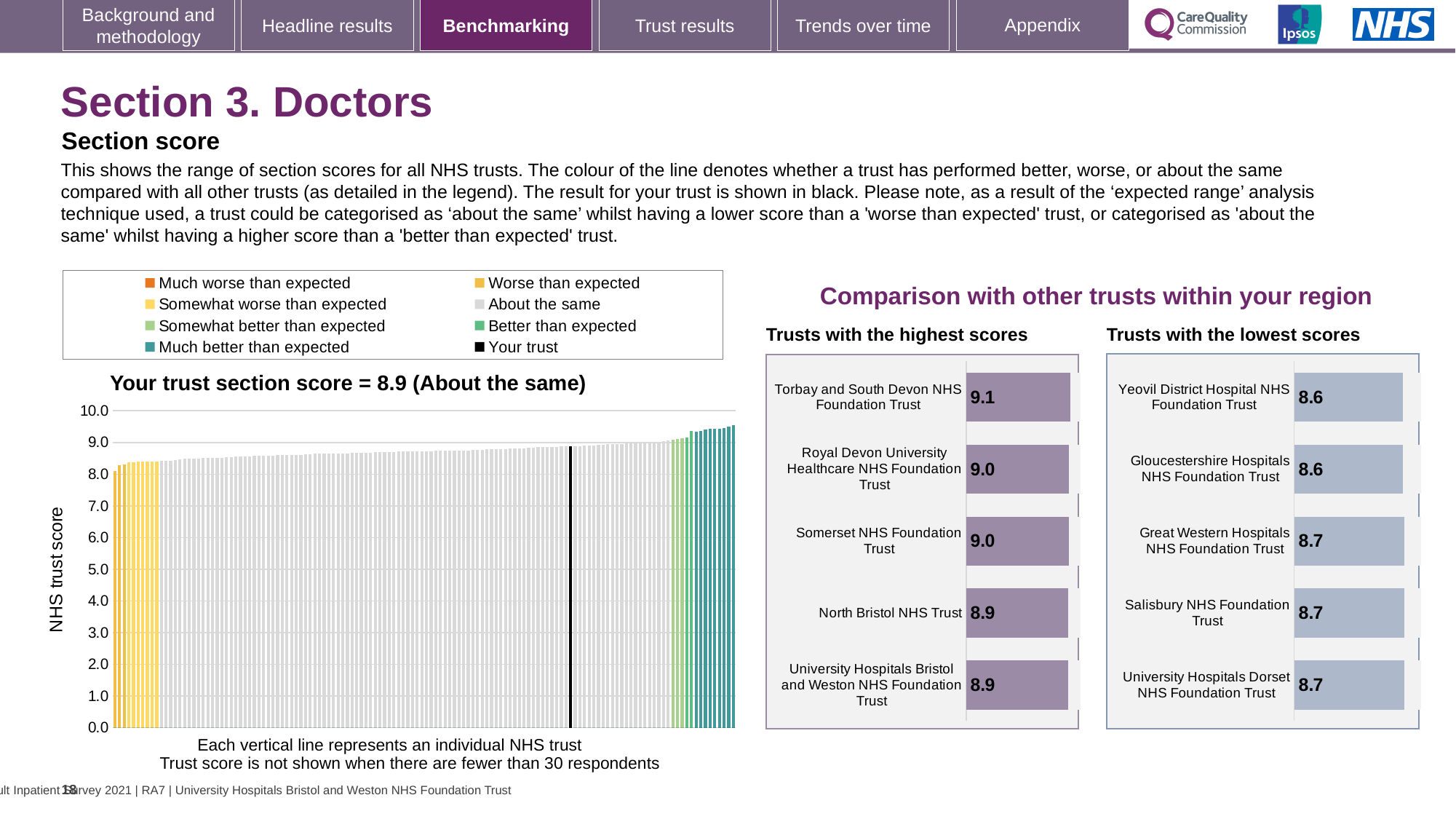
In the 'Trusts with the highest scores' chart, what is the difference between the scores of Torbay and South Devon NHS Foundation Trust and North Bristol NHS Trust? 0.2 In the 'Trusts with the highest scores' chart, what is the score for North Bristol NHS Trust? 8.9 How many trusts are listed in the 'Trusts with the lowest scores' chart? 5 In the main chart titled 'Your trust section score', do the trust scores rise or fall from left to right along the x axis? Rise What type of chart is the main chart titled 'Your trust section score = 8.9 (About the same)'? Bar chart How many entries does the legend above the main chart list? 8 In the 'Trusts with the highest scores' chart, which trust has the highest score? Torbay and South Devon NHS Foundation Trust In the 'Trusts with the lowest scores' chart, what is the score for Yeovil District Hospital NHS Foundation Trust? 8.6 In the 'Trusts with the lowest scores' chart, what is the score for Great Western Hospitals NHS Foundation Trust? 8.7 Which is larger: the score for Torbay and South Devon NHS Foundation Trust in the highest scores chart, or the score for Yeovil District Hospital NHS Foundation Trust in the lowest scores chart? Torbay and South Devon NHS Foundation Trust In the main chart titled 'Your trust section score', what is the score for your trust? 8.9 In the 'Trusts with the highest scores' chart, what is the score for Torbay and South Devon NHS Foundation Trust? 9.1